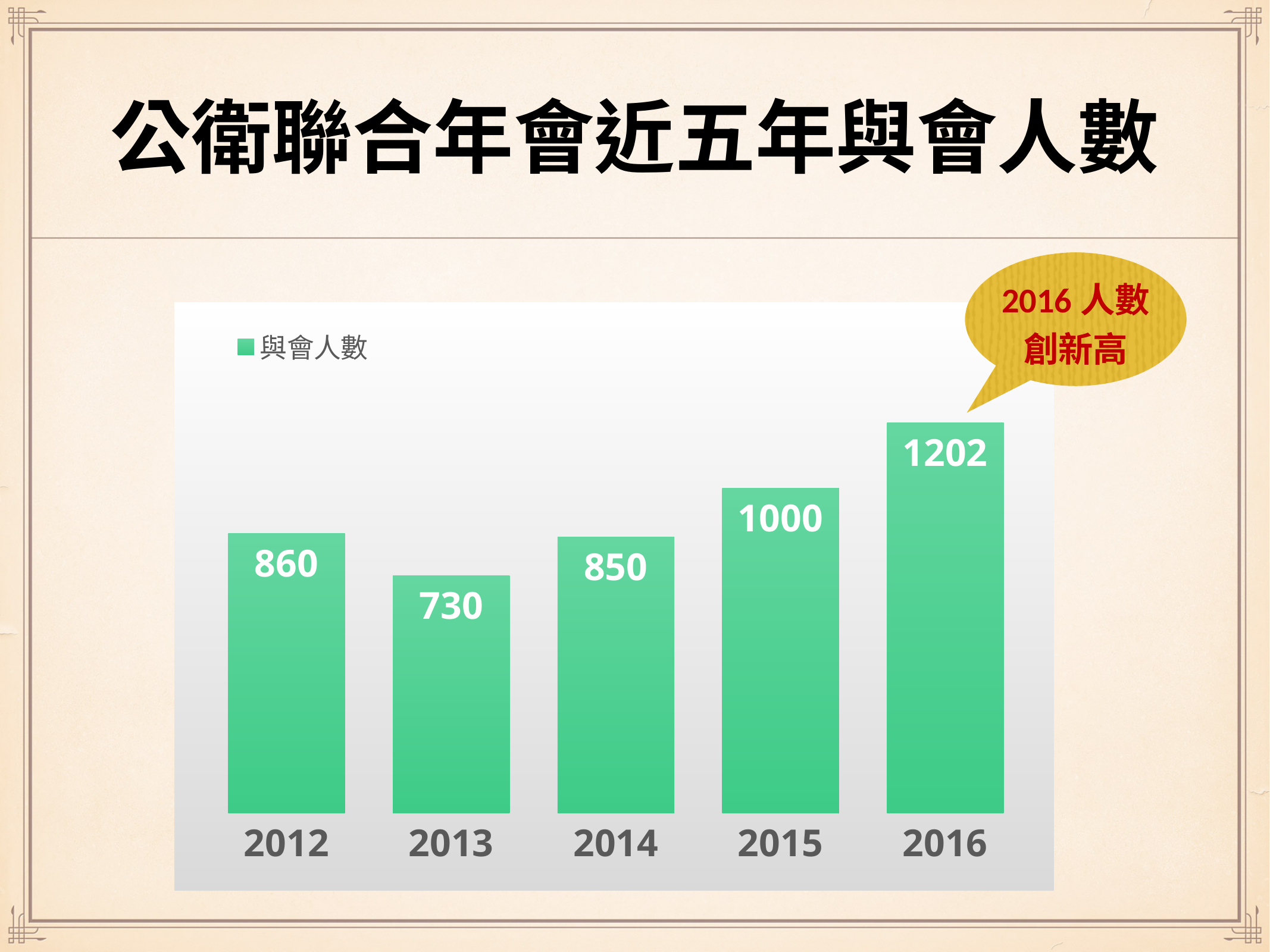
Which year has the highest value? 2016 Which year has the lowest value? 2013 How many years are shown on the x axis? 5 What is the legend entry for the series? 與會人數 Which is larger, the value for 2014 or the value for 2015? 2015 How many series does the legend list? 1 What is the value for 2015? 1000 What is the value for 2013? 730 What is the difference between the values for 2012 and 2013? 130 What is the value for 2012? 860 What is the difference between the values for 2016 and 2015? 202 What kind of chart is shown on the slide? bar chart